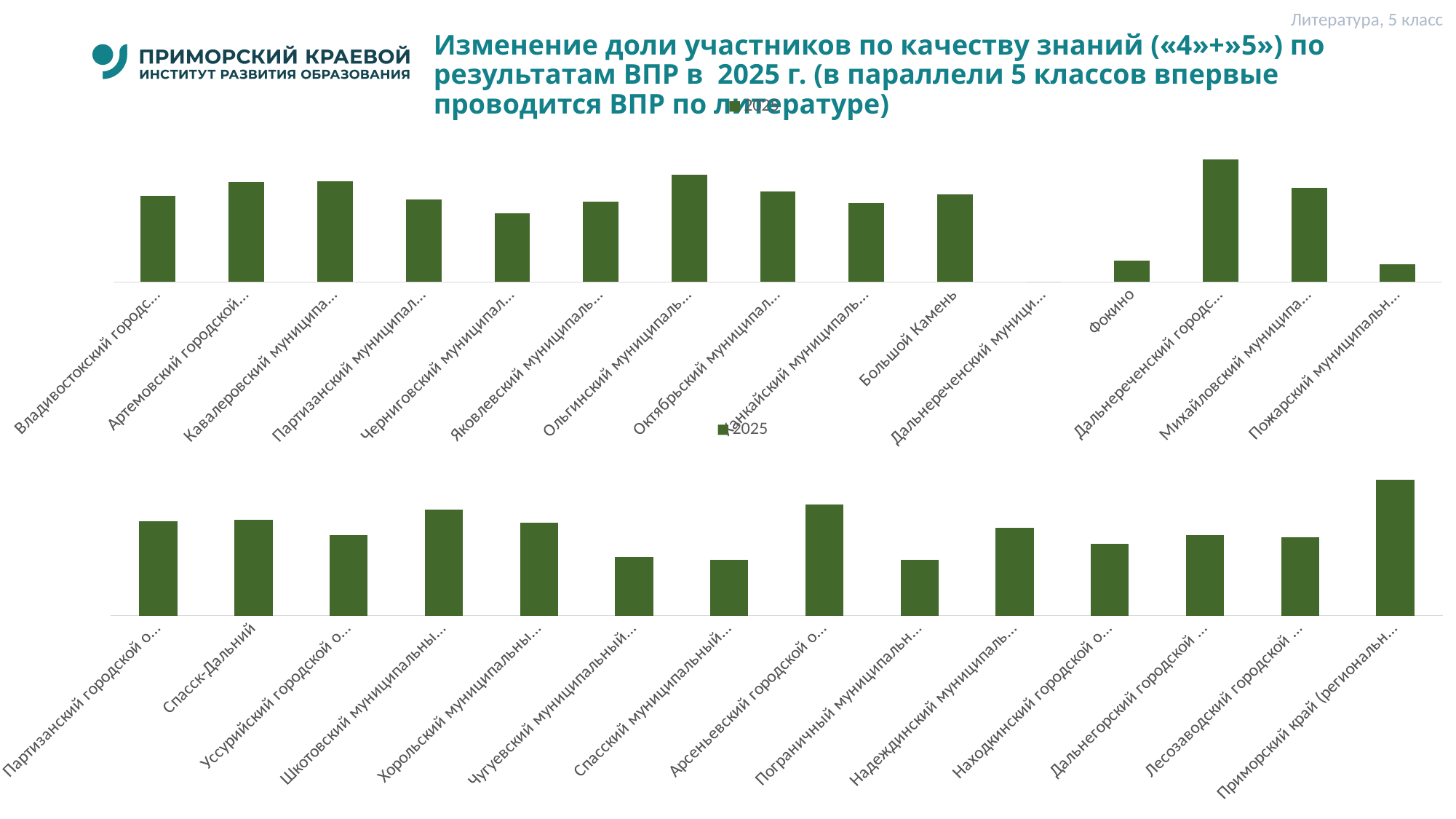
In the top chart, how many series does the legend list? 1 In the bottom chart, which is larger: the value for Арсеньевский городской о... or the value for Чугуевский муниципальный...? Арсеньевский городской о... What kind of chart is the top chart on the slide? bar chart What kind of chart is the bottom chart on the slide? bar chart In the top chart, which is larger: the value for Большой Камень or the value for Фокино? Большой Камень In the bottom chart, what series name is shown in the legend? 2025 How many categories are shown on the x axis of the bottom chart? 14 In the bottom chart, which is larger: the value for Шкотовский муниципальны... or the value for Спасский муниципальный...? Шкотовский муниципальны... In the bottom chart, which category has the highest bar? Приморский край (региональн...) What subject and grade are indicated in the top-right corner of the slide? Литература, 5 класс In the top chart, which category has the highest bar? Дальнереченский городс...